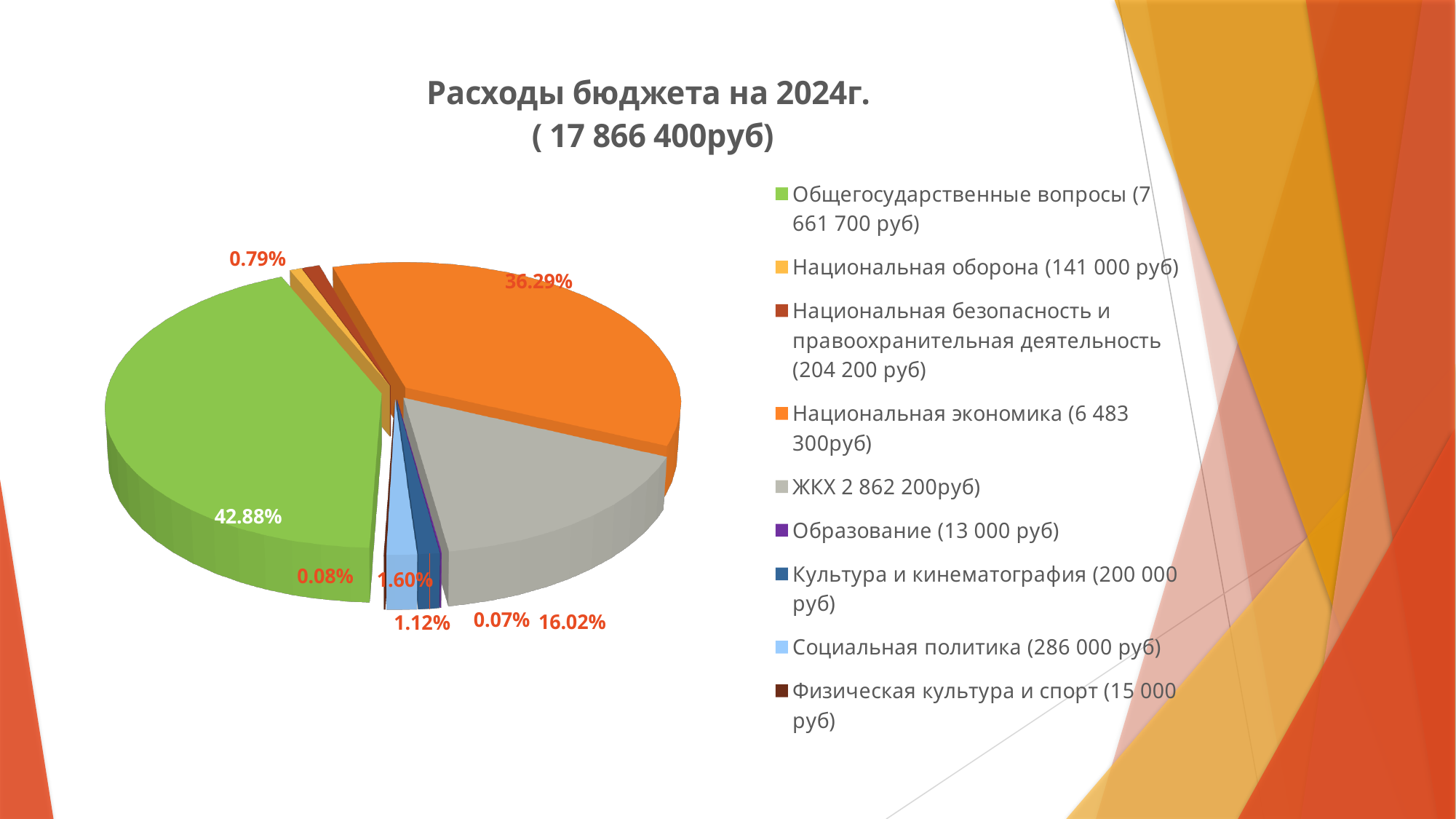
What percentage share is labelled for Общегосударственные вопросы? 42.88% What is the title of the chart? Расходы бюджета на 2024г. ( 17 866 400руб) According to the legend, what amount in rubles is allocated to Национальная оборона? 141 000 руб How many categories does the legend of the pie chart list? 9 Which category has the largest slice of the pie? Общегосударственные вопросы What colour represents Общегосударственные вопросы in the pie chart? green What percentage share is labelled for ЖКХ? 16.02% According to the legend, what amount in rubles is allocated to Социальная политика? 286 000 руб What kind of chart is shown on the slide? pie chart What is the difference in percentage points between the Общегосударственные вопросы slice and the Национальная экономика slice? 6.59% Which slice is larger, Национальная экономика or ЖКХ? Национальная экономика What percentage share is labelled for Национальная экономика? 36.29%